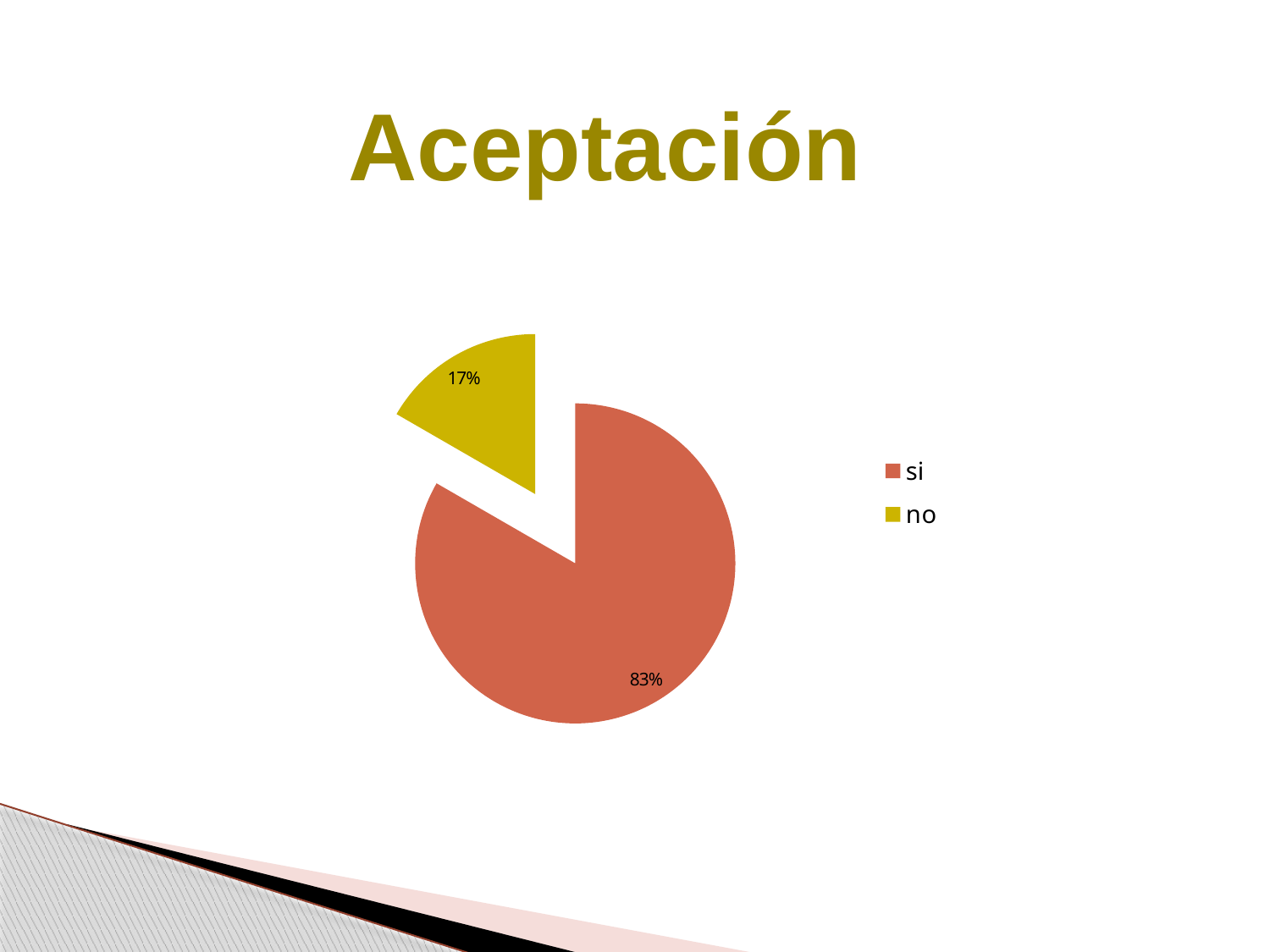
How many slices does the pie chart have? 2 What is the difference in percentage points between the "si" and "no" slices? 66 How many entries does the legend list? 2 What kind of chart is shown on the slide? pie chart Which is larger, the "si" slice or the "no" slice? si Which slice is the smallest in the pie chart? no What share of the pie does the "si" slice represent? 83% What share of the pie does the "no" slice represent? 17% Which slice is the largest in the pie chart? si What colour is the "no" slice? yellow What is the title of the slide? Aceptación